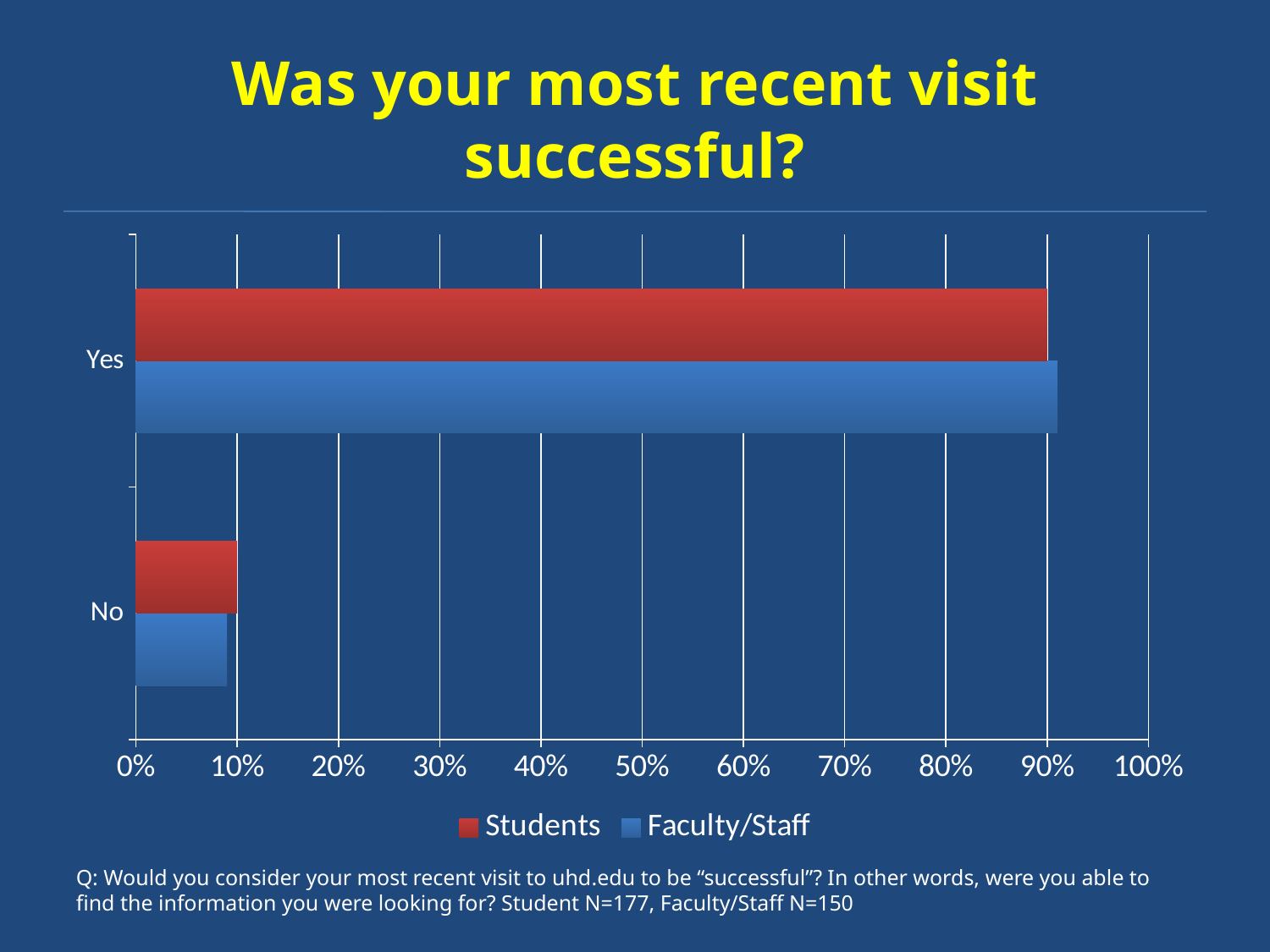
Is the value for Faculty/Staff in the Yes category greater or less than 80%? greater What is the value for Students in the Yes category? 90% For Faculty/Staff, which category has the larger value, Yes or No? Yes What is the title of the chart? Was your most recent visit successful? Is the value for Faculty/Staff in the No category greater or less than 20%? less How many categories are shown on the chart? 2 How many series does the legend list? 2 What kind of chart is shown on the slide? bar chart Which series is shown in red? Students Which category has the highest value for Faculty/Staff? Yes What is the value for Students in the No category? 10% Which category has the lowest value for Students? No